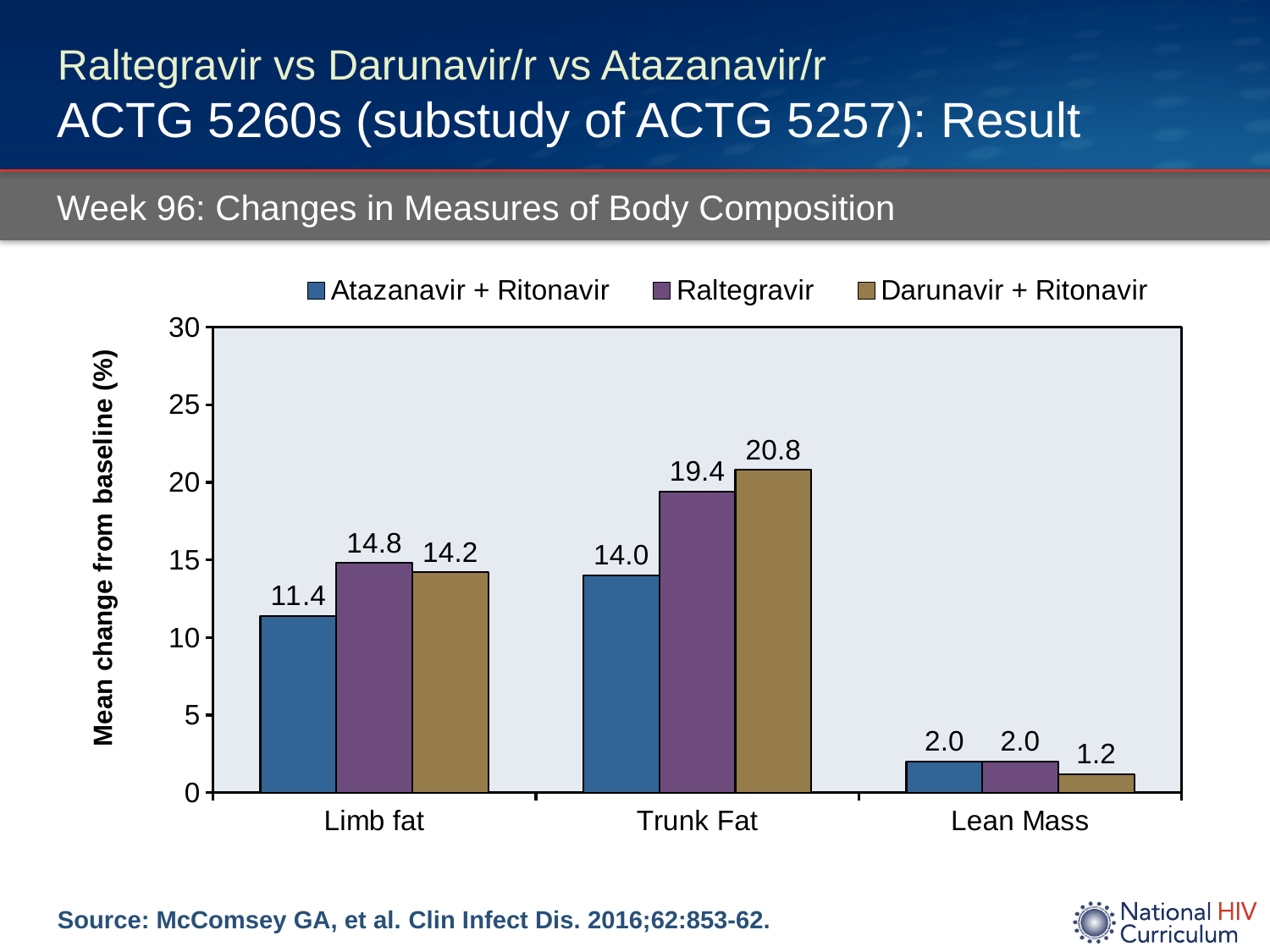
What is the mean change from baseline in lean mass for the Raltegravir group? 2.0 Is the Atazanavir + Ritonavir value for trunk fat greater or less than 15? less What is the mean change from baseline in limb fat for the Atazanavir + Ritonavir group? 11.4 What is the label of the y axis? Mean change from baseline (%) How many series does the legend list? 3 Which is larger for limb fat: the Raltegravir value or the Darunavir + Ritonavir value? Raltegravir Which treatment group has the lowest mean change in lean mass? Darunavir + Ritonavir Which treatment group has the highest mean change in trunk fat? Darunavir + Ritonavir What is the mean change from baseline in trunk fat for the Darunavir + Ritonavir group? 20.8 What is the difference between the Raltegravir and Atazanavir + Ritonavir values for trunk fat? 5.4 What kind of chart is shown on the slide? Bar chart How many body composition categories are shown on the x axis? 3